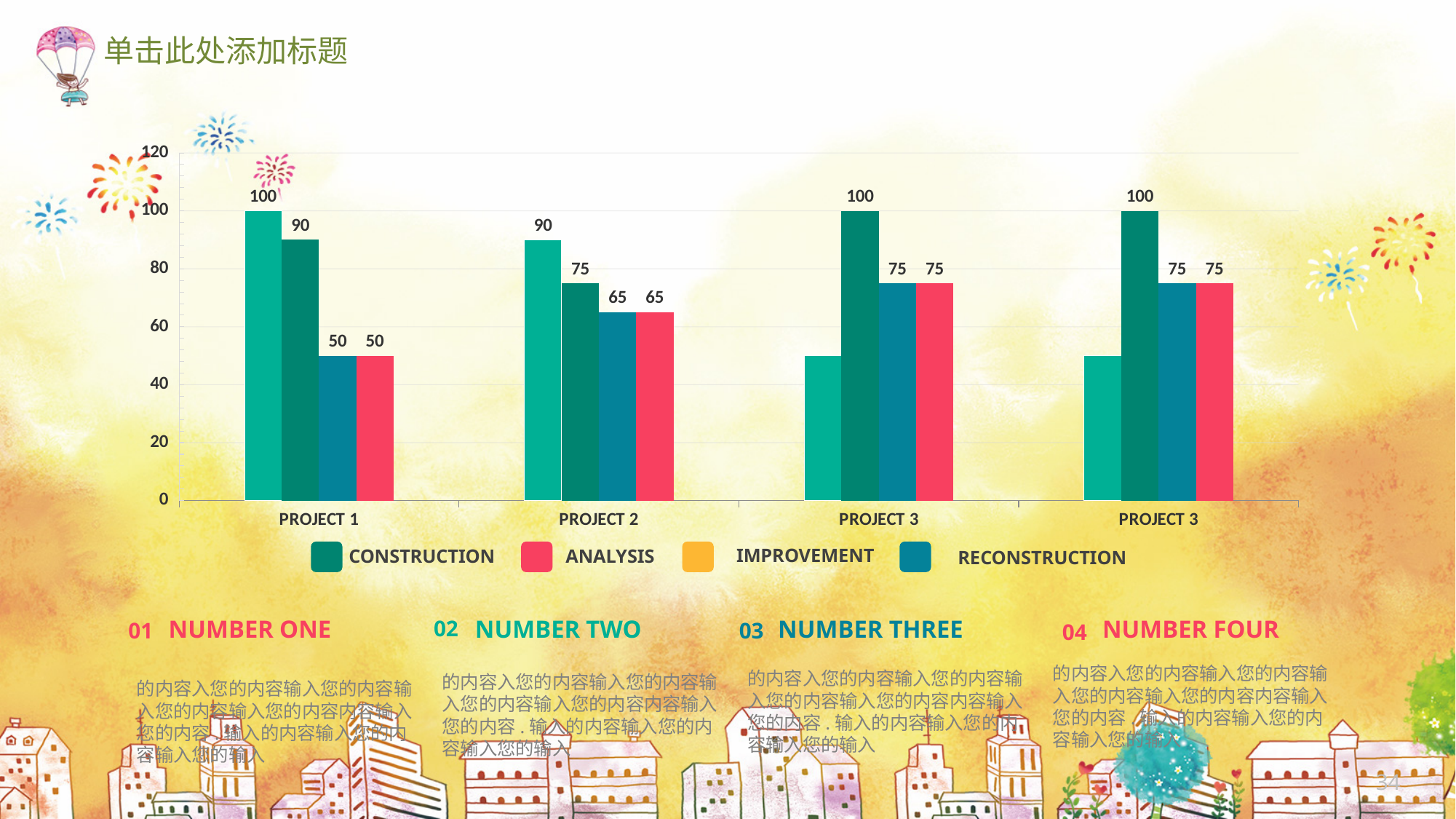
What is the value of the tallest bar in the PROJECT 2 group? 90 In PROJECT 2, what is the difference between the CONSTRUCTION value and the RECONSTRUCTION value? 10 Is the value of the unlabeled light teal bar in the PROJECT 3 group greater or less than 60? less What is the RECONSTRUCTION (dark teal) value for PROJECT 1? 50 What is the CONSTRUCTION (dark green) value for PROJECT 1? 90 What kind of chart is shown on the slide? bar chart What is the ANALYSIS (pink) value for PROJECT 2? 65 Is the CONSTRUCTION value larger for PROJECT 1 or for PROJECT 2? PROJECT 1 In PROJECT 1, what is the difference between the CONSTRUCTION value and the ANALYSIS value? 40 How many series does the legend list? 4 What is the CONSTRUCTION (dark green) value for PROJECT 3? 100 How many category groups are shown along the x axis? 4